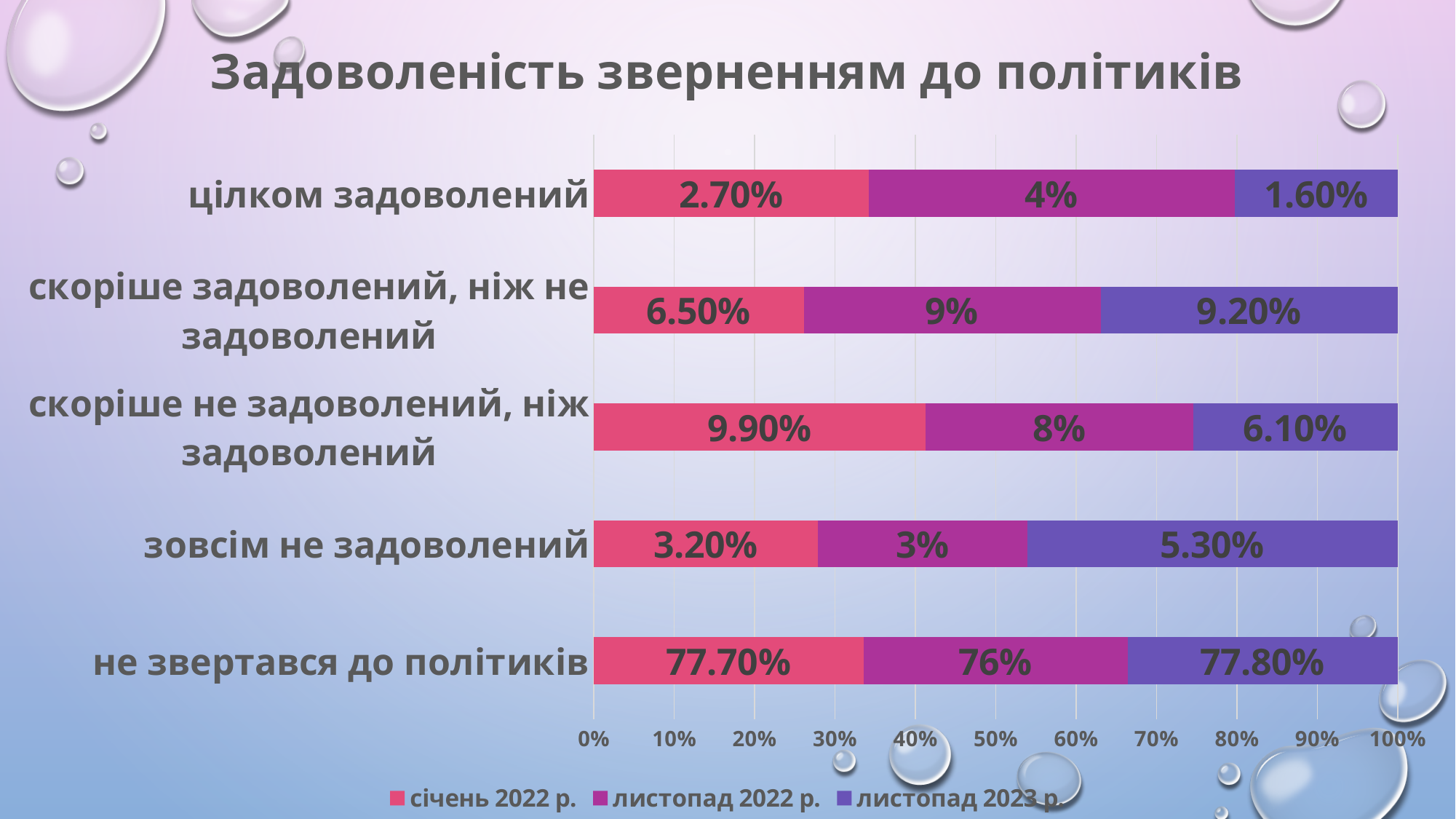
Which category has the lowest value in the 'січень 2022 р.' series? цілком задоволений What is the value for 'цілком задоволений' in the 'листопад 2023 р.' series? 1.60% How many series does the legend list? 3 What is the value for 'не звертався до політиків' in the 'січень 2022 р.' series? 77.70% For 'скоріше задоволений, ніж не задоволений', which series has the larger value: 'січень 2022 р.' or 'листопад 2023 р.'? листопад 2023 р. How many categories are shown on the chart? 5 What is the value for 'скоріше не задоволений, ніж задоволений' in the 'листопад 2022 р.' series? 8% What is the difference between the 'листопад 2023 р.' and 'січень 2022 р.' values for 'зовсім не задоволений'? 2.10% What is the title of the chart? Задоволеність зверненням до політиків What kind of chart is shown on the slide? bar chart Which series is shown in pink on the chart? січень 2022 р. Which category has the highest value in the 'листопад 2023 р.' series? не звертався до політиків